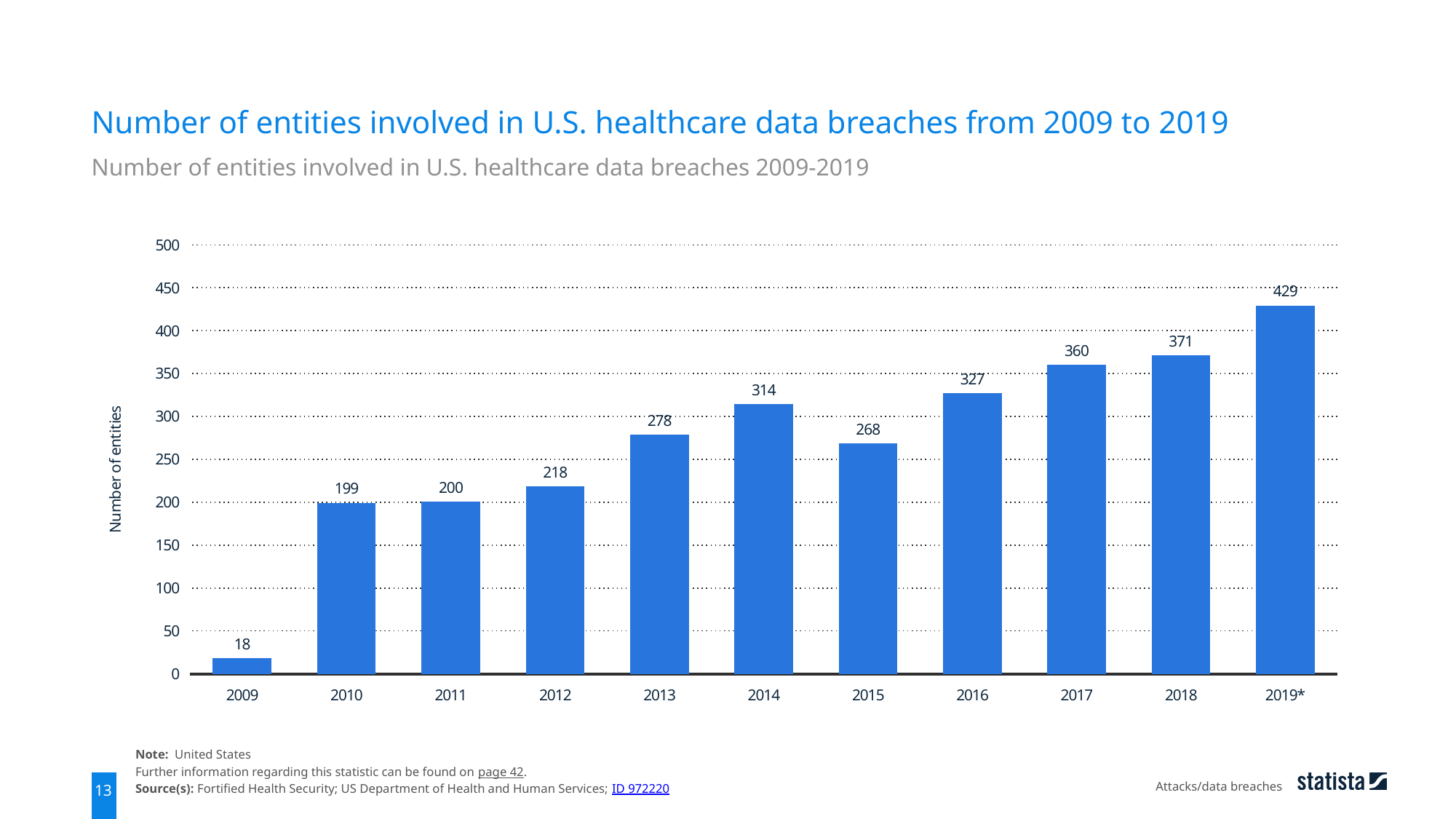
Is the value for 2016 greater or less than 300? greater What is the value shown for 2009? 18 Which year has a larger value, 2014 or 2015? 2014 What is the difference between the values for 2019* and 2009? 411 Which year has the highest number of entities involved in data breaches? 2019* What kind of chart is shown on the slide? Bar chart What is the number of entities involved in U.S. healthcare data breaches in 2014? 314 What is the difference between the values for 2018 and 2017? 11 How many years are shown on the x axis? 11 What is the value shown for 2019*? 429 What is the label of the y axis? Number of entities Which year has the lowest number of entities involved in data breaches? 2009